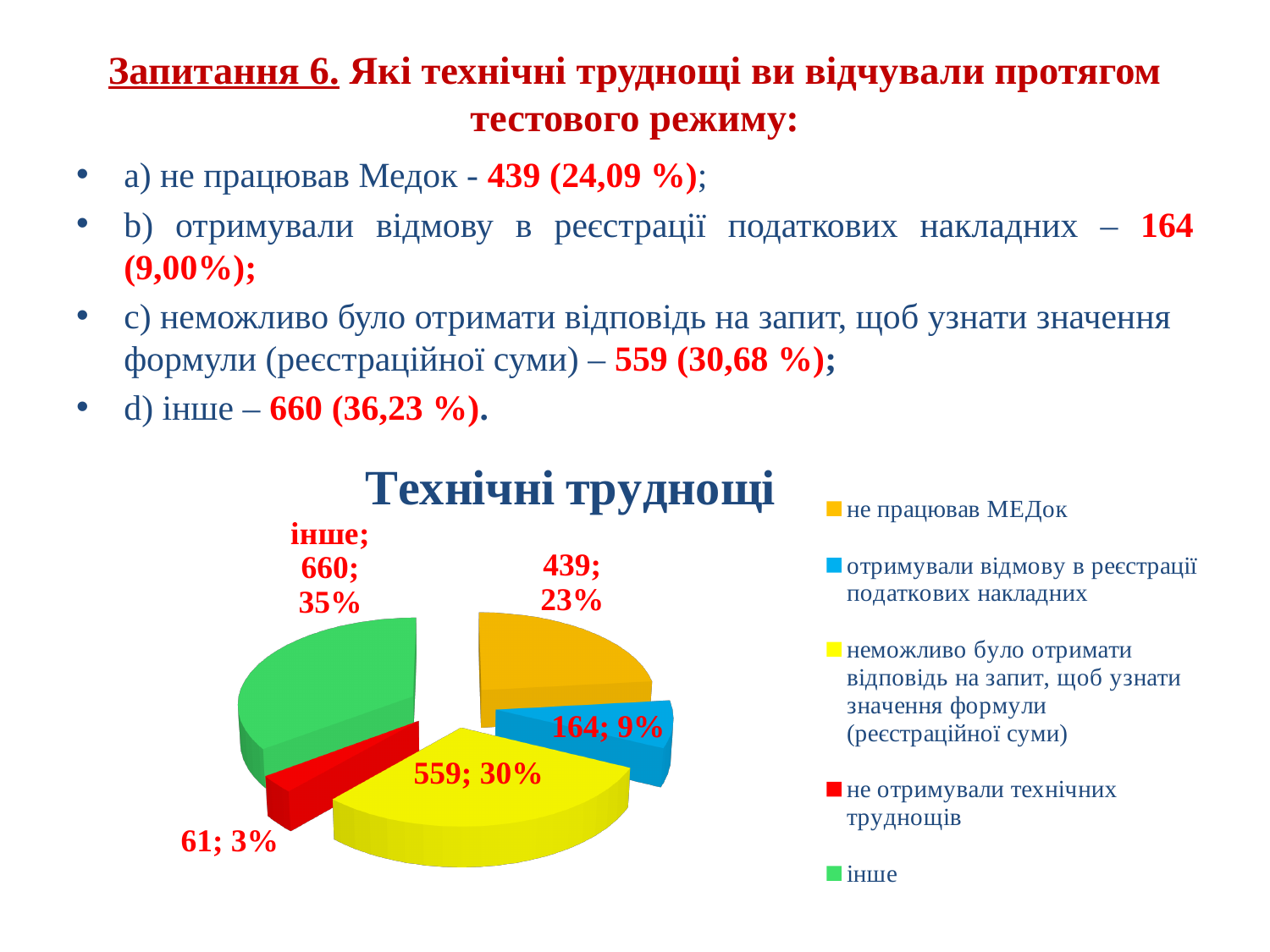
How many slices does the pie chart have? 5 Which is larger: the value for 'неможливо було отримати відповідь на запит' or the value for 'не працював МЕДок'? неможливо було отримати відповідь на запит Which category has the largest slice in the pie chart? інше What is the value for 'не отримували технічних труднощів'? 61 What is the difference between the value for 'інше' and the value for 'не працював МЕДок'? 221 What kind of chart is shown on the slide? pie chart What is the title of the chart? Технічні труднощі What is the value for 'отримували відмову в реєстрації податкових накладних'? 164 What share of the pie does the 'неможливо було отримати відповідь на запит' slice represent? 30% Which category has the smallest slice in the pie chart? не отримували технічних труднощів What is the value for 'не працював МЕДок' in the pie chart? 439 How many entries does the legend list? 5